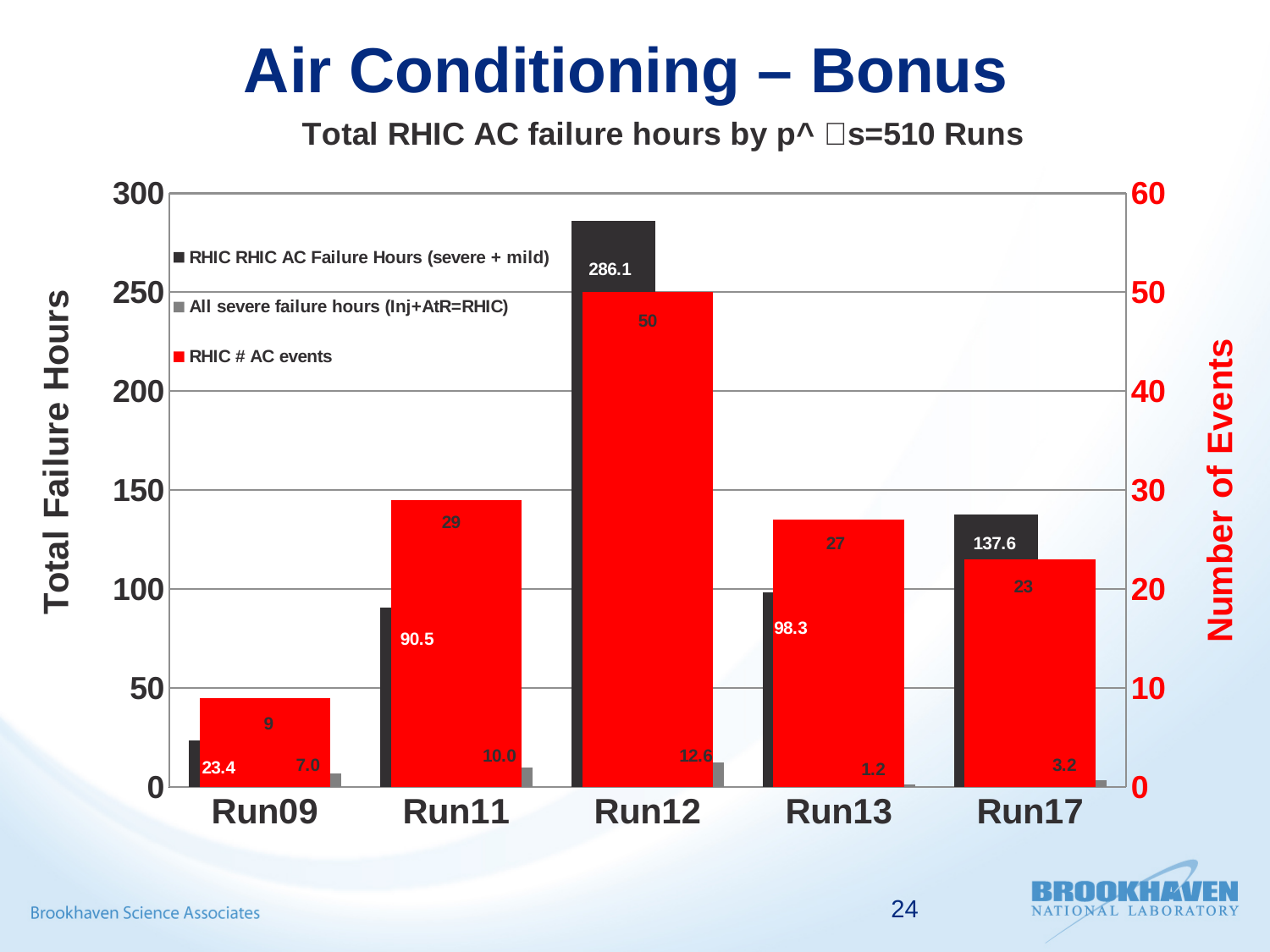
What is the All severe failure hours value for Run13? 1.2 How many series does the legend list? 3 What kind of chart is shown on the slide? bar chart What is the RHIC AC Failure Hours (severe + mild) value for Run12? 286.1 Is the RHIC AC Failure Hours (severe + mild) value for Run11 greater or less than 100? less How many RHIC AC events are shown for Run11? 29 How many runs are shown on the x axis? 5 What is the difference in RHIC AC Failure Hours (severe + mild) between Run17 and Run13? 39.3 Which run has the highest RHIC AC Failure Hours (severe + mild)? Run12 What is the label of the right-hand vertical axis? Number of Events Which run has more RHIC AC events, Run13 or Run17? Run13 Which run has the lowest number of RHIC AC events? Run09